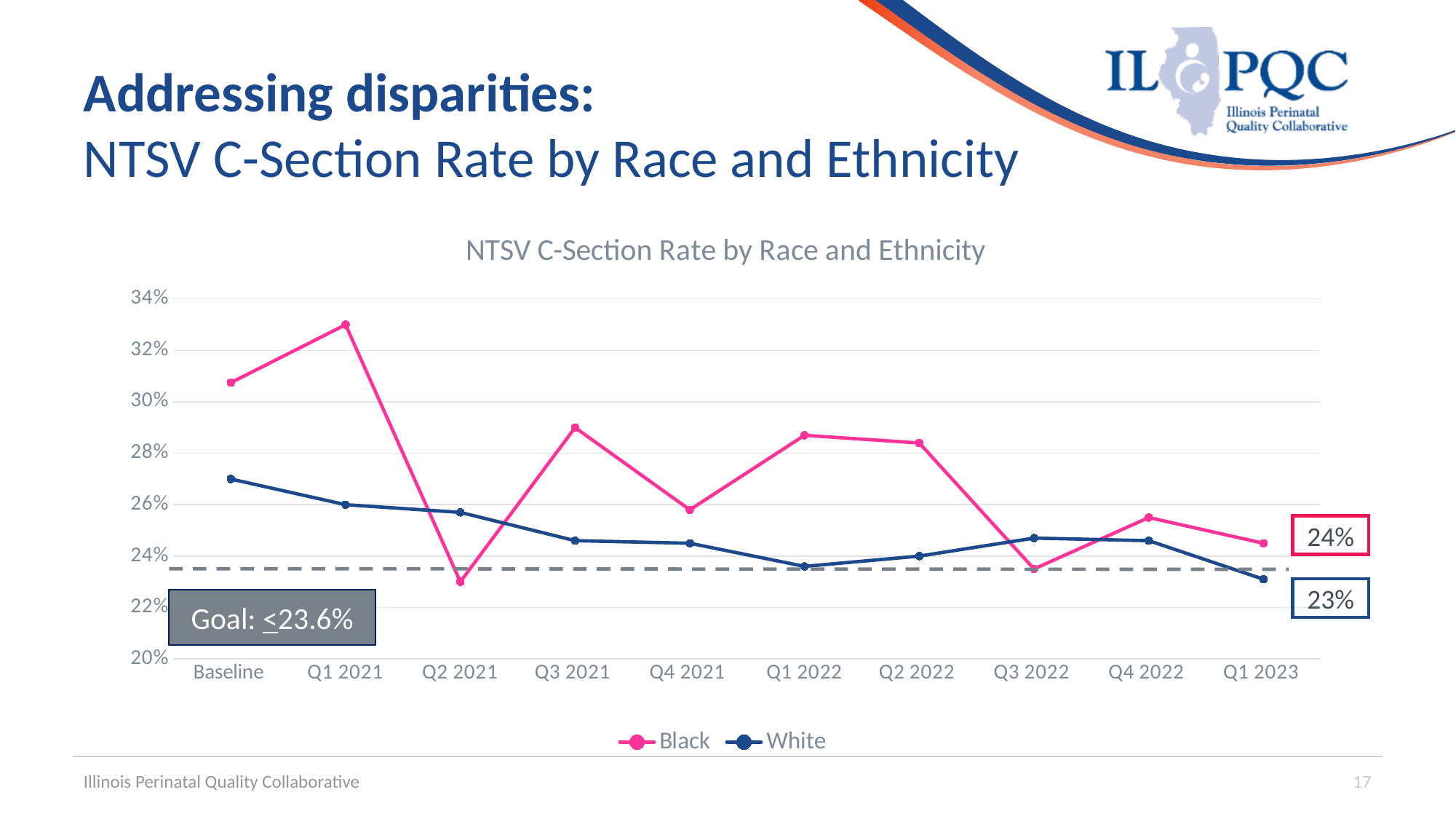
Is the value for Black at Q1 2021 greater or less than 32%? greater At which time point is the White series highest? Baseline Is the value for Black at Q2 2021 greater or less than 24%? less What kind of chart is shown on the slide? line chart What is the difference between the Black and White values at Q1 2023? 1% What goal value is shown in the box on the chart? ≤23.6% What is the labelled value for the Black series at Q1 2023? 24% At Q2 2021, which series has the larger value, Black or White? White How many series does the legend list? 2 How many time points are plotted along the x axis? 10 At which time point is the Black series highest? Q1 2021 What is the labelled value for the White series at Q1 2023? 23%